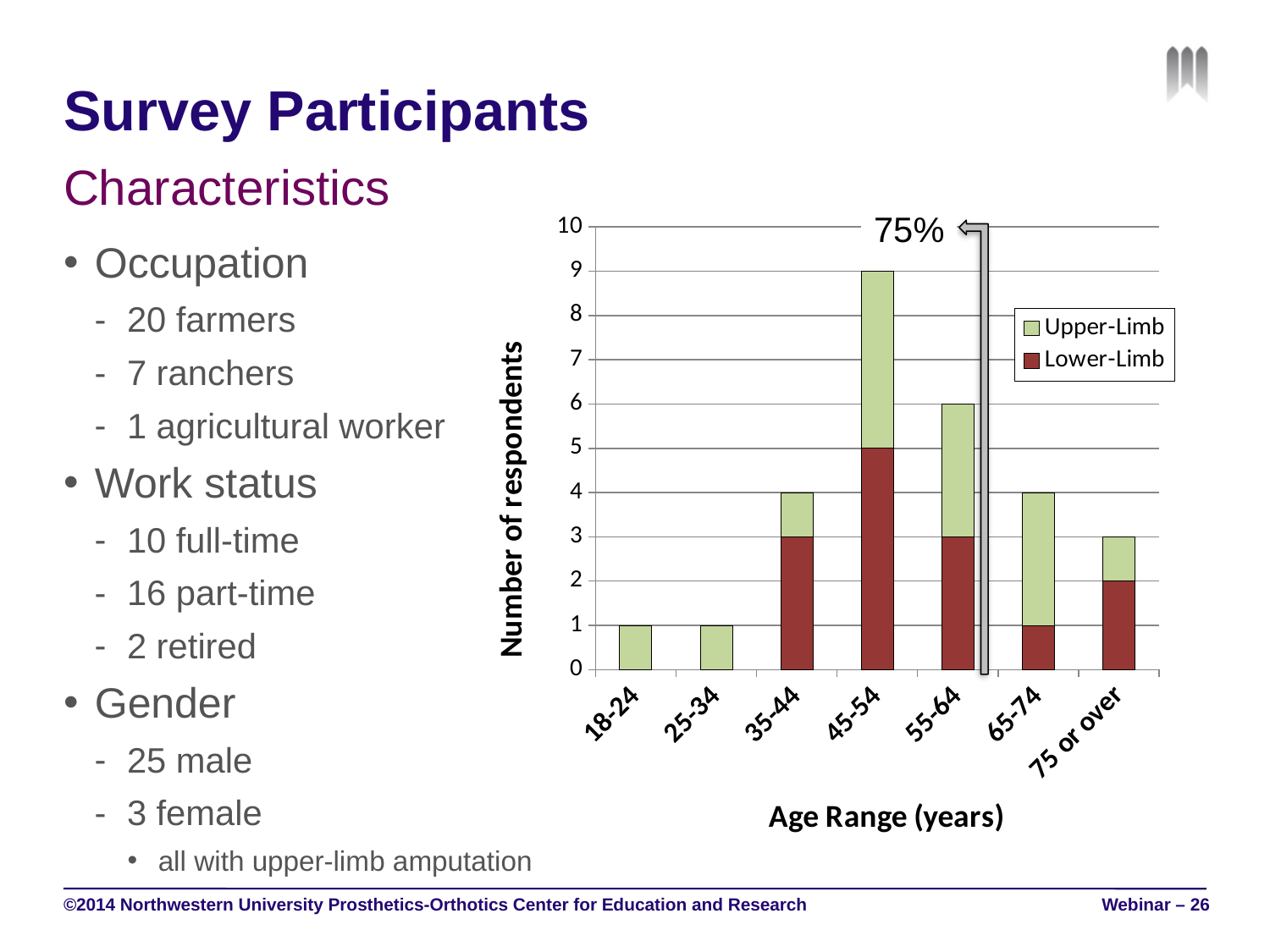
What is the total number of respondents in the 55-64 age range? 6 How many age range categories are shown on the x axis? 7 How many series does the chart legend list? 2 Which age range has the highest total number of respondents? 45-54 How many Lower-Limb respondents are in the 45-54 age range? 5 What is the difference between the total respondents in the 45-54 and 55-64 age ranges? 3 What kind of chart is shown on the slide? stacked bar chart What percentage is annotated on the chart next to the vertical marker line? 75% Is the total number of respondents in the 45-54 age range greater or less than 5? greater What is the label of the y axis? Number of respondents What is the total number of respondents in the 45-54 age range? 9 Which age range has more total respondents, 45-54 or 55-64? 45-54